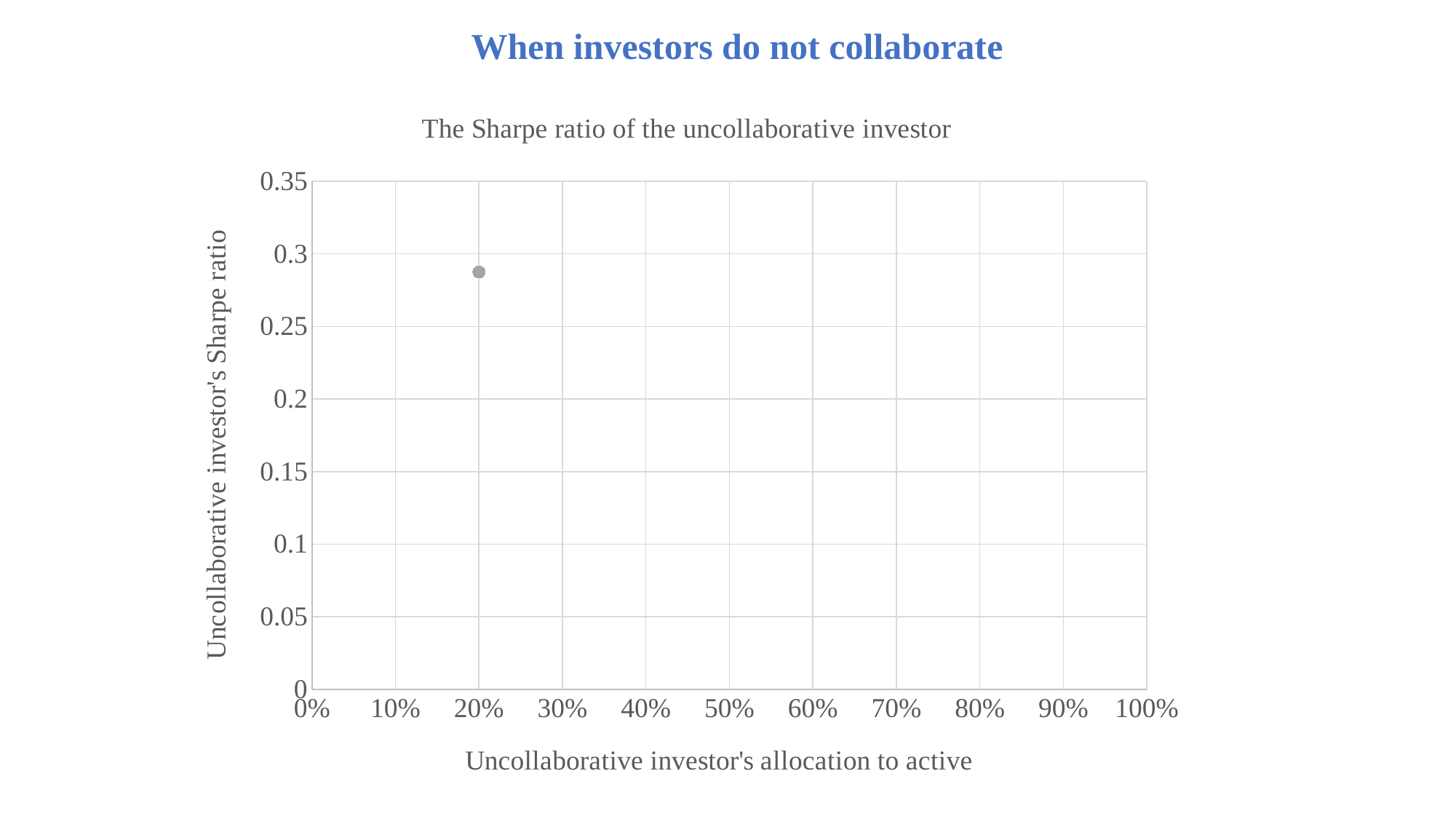
At what allocation to active is the single data point plotted on the x axis? 20% How many data points are plotted on the chart? 1 Is the Sharpe ratio of the plotted point greater or less than 0.3? less What is the maximum value shown on the y axis? 0.35 What kind of chart is shown on the slide? scatter chart What is the label of the x axis? Uncollaborative investor's allocation to active What is the maximum value shown on the x axis? 100% Is the Sharpe ratio of the plotted point greater or less than 0.2? greater Is the Sharpe ratio of the plotted point greater or less than 0.25? greater What is the title of the chart? The Sharpe ratio of the uncollaborative investor